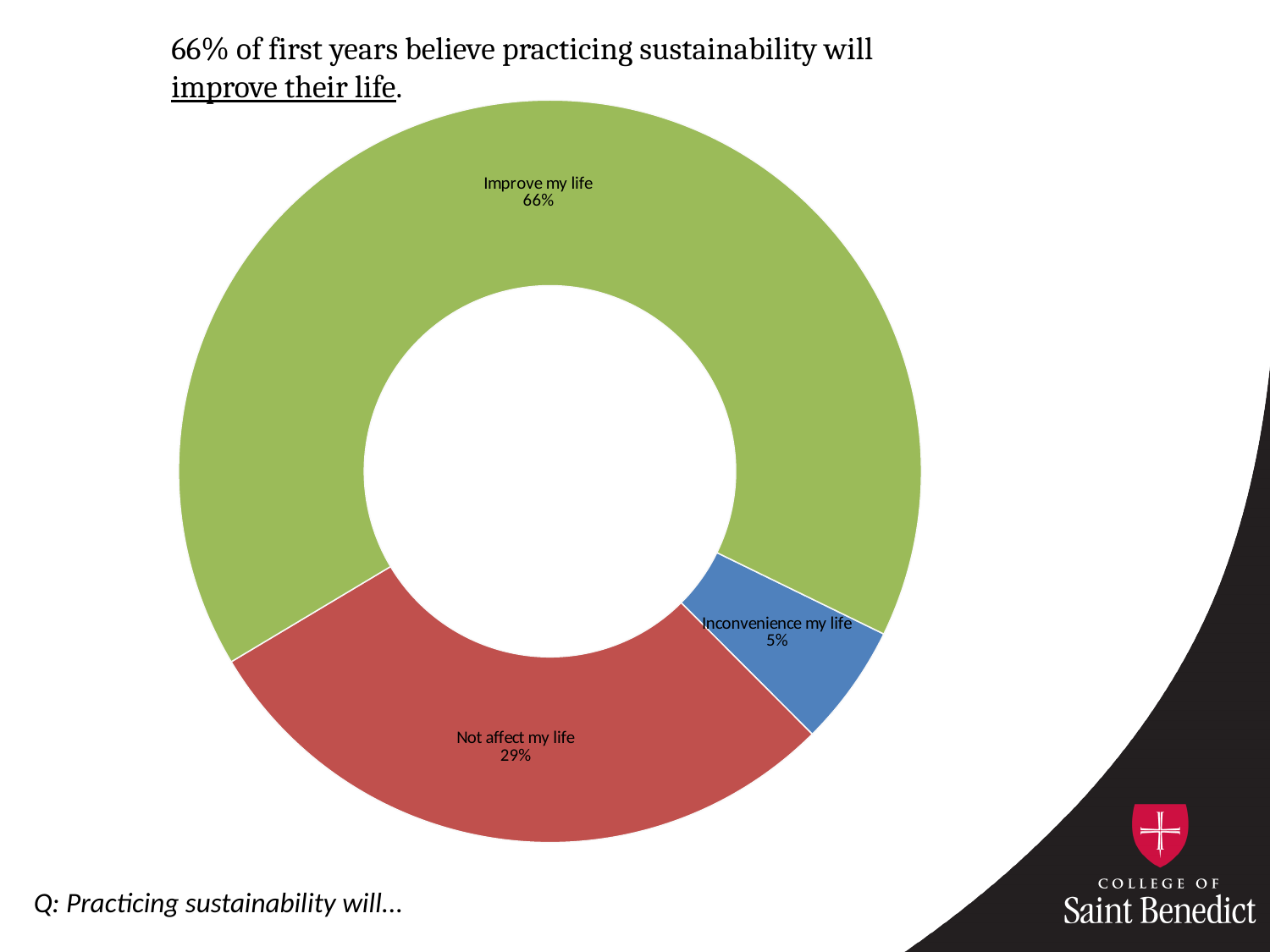
How many response categories are shown in the chart? 3 Which response has the largest share of the chart? Improve my life What percentage of first years said practicing sustainability will not affect their life? 29% What colour is the 'Not affect my life' segment? Red What survey question does the chart answer, as shown at the bottom of the slide? Practicing sustainability will... Which is larger: the share for 'Not affect my life' or 'Inconvenience my life'? Not affect my life What percentage of first years said practicing sustainability will inconvenience their life? 5% What percentage of first years said practicing sustainability will improve their life? 66% What kind of chart is shown on the slide? Pie chart (doughnut) What is the difference in percentage points between 'Improve my life' and 'Not affect my life'? 37 Which response has the smallest share of the chart? Inconvenience my life What is the difference in percentage points between 'Not affect my life' and 'Inconvenience my life'? 24